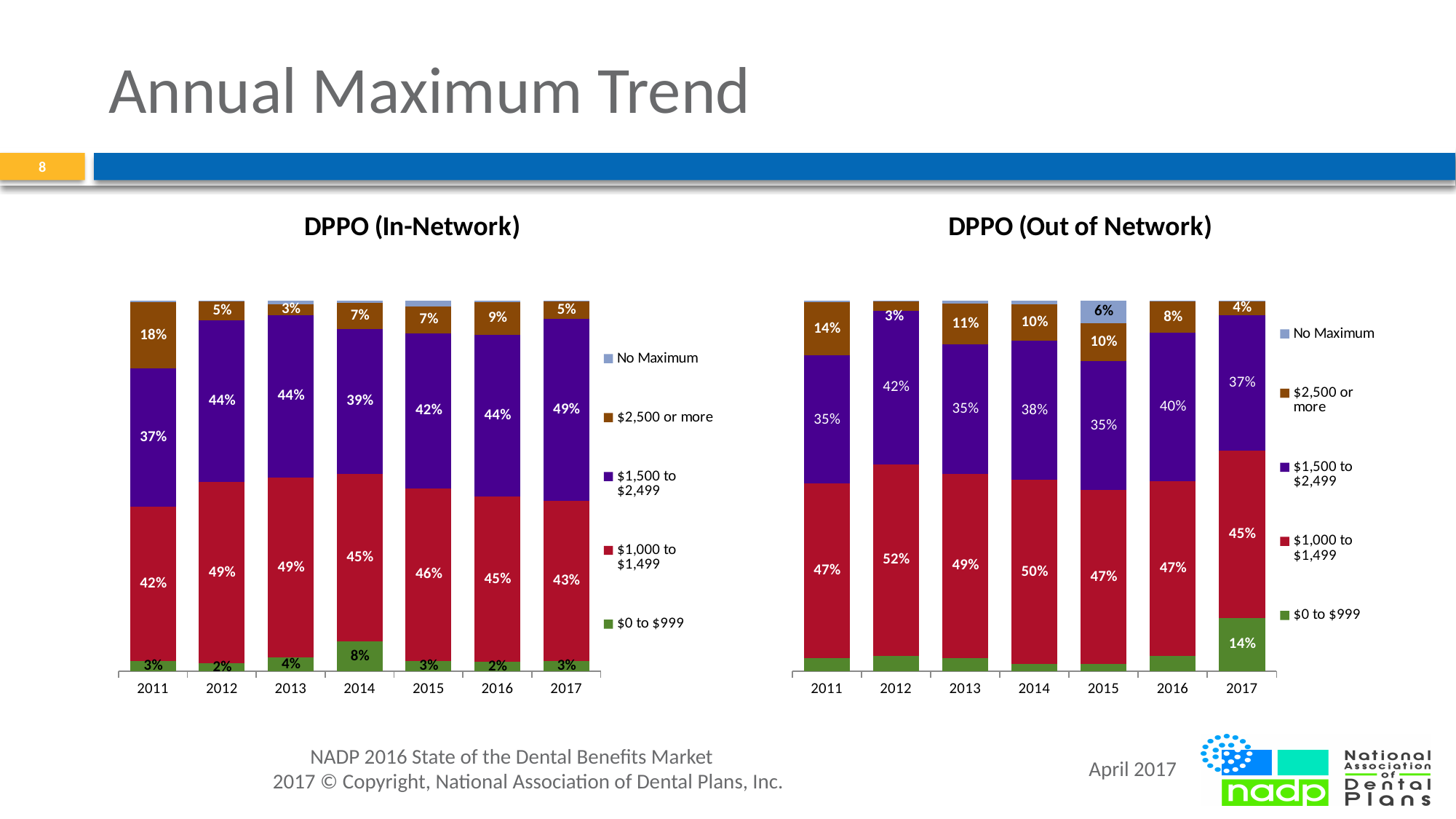
In the DPPO (Out of Network) chart, which year has the lowest value for $2,500 or more? 2012 In the DPPO (In-Network) chart, what is the value for $2,500 or more in 2011? 18% In the DPPO (Out of Network) chart, which is larger: the $1,500 to $2,499 value in 2012 or in 2017? 2012 In the DPPO (In-Network) chart, which year has the highest value for $1,500 to $2,499? 2017 In the DPPO (In-Network) chart, what is the difference between the $1,000 to $1,499 values for 2012 and 2017? 6% In the DPPO (In-Network) chart, what is the value for $0 to $999 in 2014? 8% How many series does the legend of the DPPO (Out of Network) chart list? 5 In the DPPO (Out of Network) chart, what is the value for $0 to $999 in 2017? 14% What kind of chart is the DPPO (In-Network) chart? Stacked bar chart In the DPPO (Out of Network) chart, what is the value for $1,000 to $1,499 in 2012? 52% How many years are shown on the x axis of the DPPO (In-Network) chart? 7 In the DPPO (Out of Network) chart, which year shows a labelled No Maximum value of 6%? 2015